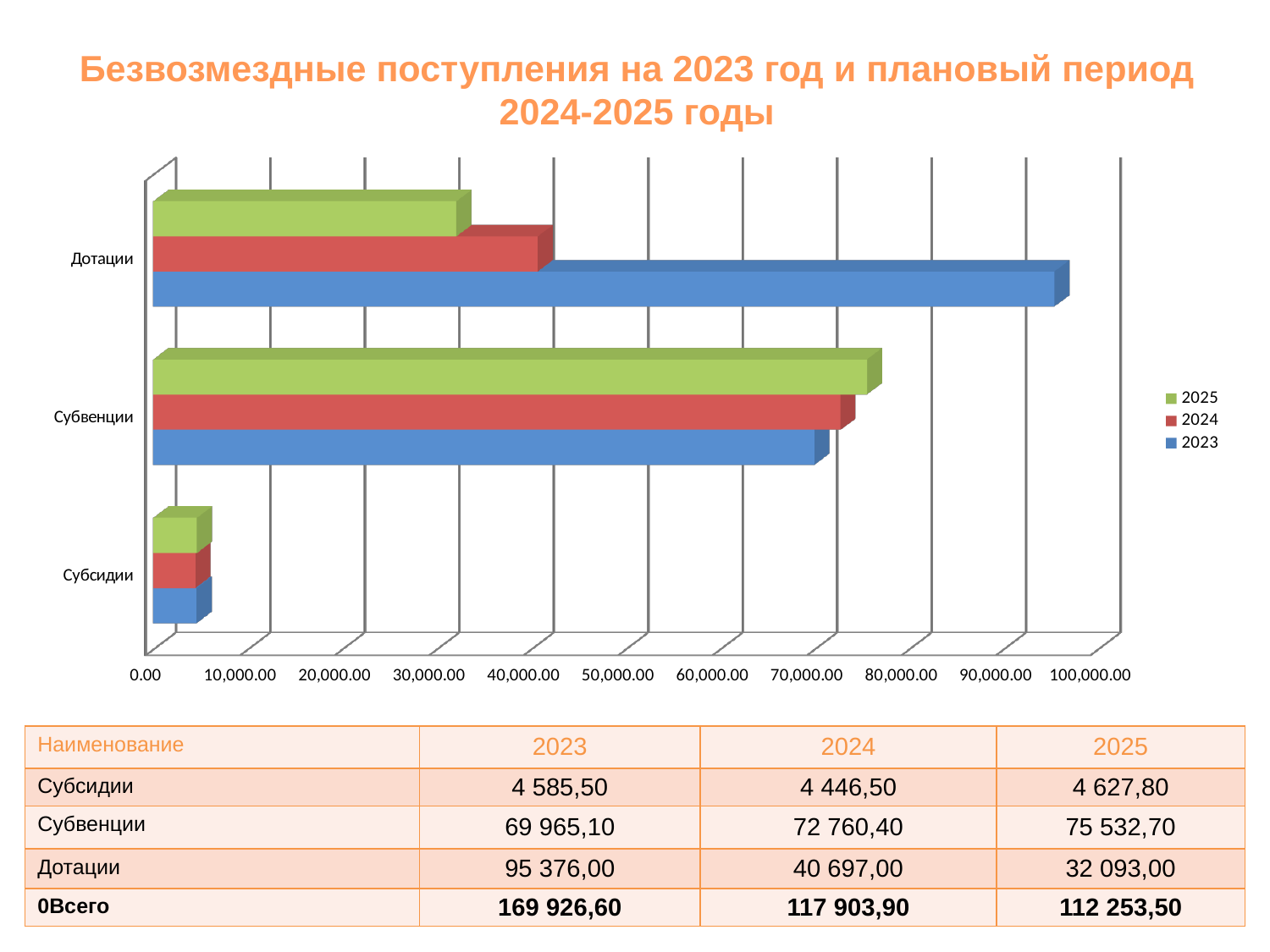
Which colour represents the 2025 series in the chart legend? green Which category has the highest value in 2023? Дотации How many series does the chart legend list? 3 Is the 2023 bar for Дотации greater or less than 90,000.00? greater How many categories are shown on the chart's vertical axis? 3 What is the value for Дотации in 2023? 95 376,00 Which is larger for Субвенции: the 2024 value or the 2023 value? 2024 What kind of chart is shown on the slide? bar chart What is the value for Субсидии in 2024? 4 446,50 What is the value for Субвенции in 2025? 75 532,70 What is the difference between the Дотации values for 2023 and 2024? 54 679,00 Which category has the lowest value in 2025? Субсидии